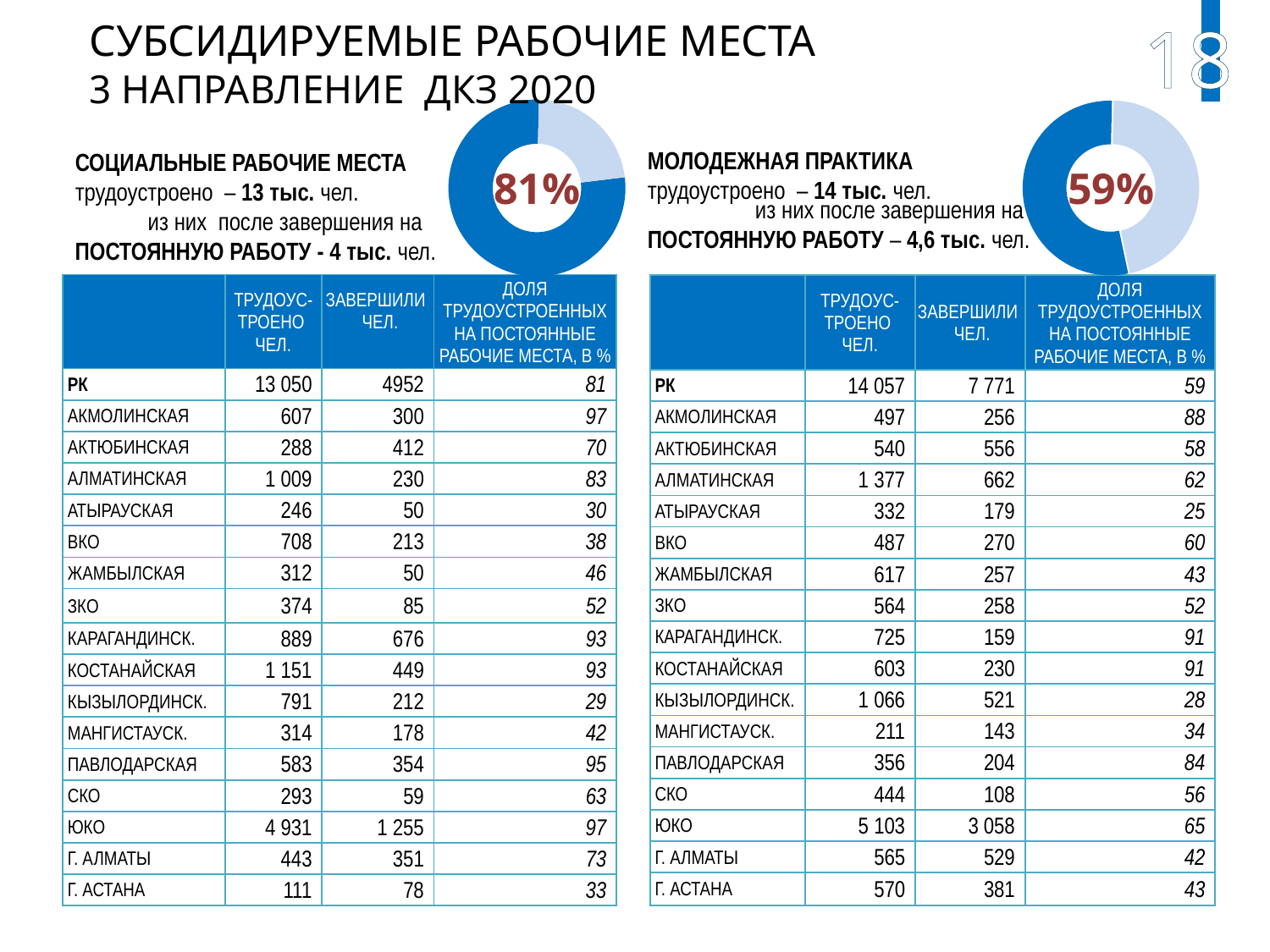
Which donut chart shows the larger share, the left one (СОЦИАЛЬНЫЕ РАБОЧИЕ МЕСТА) or the right one (МОЛОДЕЖНАЯ ПРАКТИКА)? The left one (81%) What percentage is printed in the centre of the right donut chart (МОЛОДЕЖНАЯ ПРАКТИКА)? 59% In the right donut chart, is the highlighted share greater or less than 75%? less What percentage is printed in the centre of the left donut chart (СОЦИАЛЬНЫЕ РАБОЧИЕ МЕСТА)? 81% How many slices does each donut chart on the slide have? 2 How many donut charts are on the slide? 2 What is the difference in percentage points between the share shown in the left donut chart (81%) and the right donut chart (59%)? 22 In the left donut chart, is the highlighted share greater or less than 50%? greater What kind of chart is shown next to the 'СОЦИАЛЬНЫЕ РАБОЧИЕ МЕСТА' block? Donut (pie) chart What colour is the larger slice in the left donut chart? Dark blue